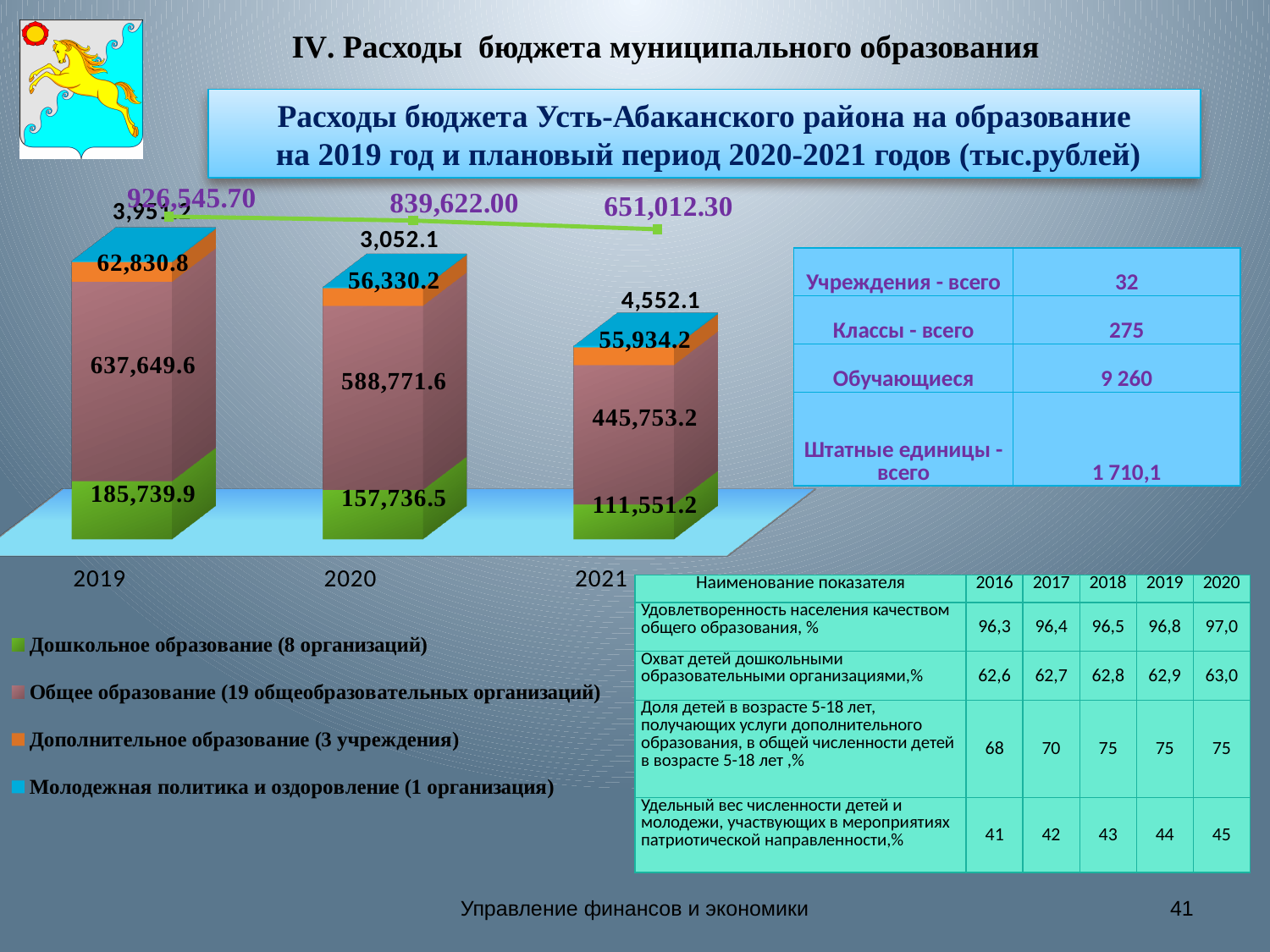
What is the value for Молодежная политика и оздоровление in 2021? 4,552.1 What is the value for Дополнительное образование in 2020? 56,330.2 In which year is the value for Дошкольное образование the lowest? 2021 What is the value for Общее образование in 2019? 637,649.6 How many years are shown on the x axis of the chart? 3 What value does the line above the bars show for 2019? 926,545.70 How many series does the chart legend list? 4 What is the difference between the Дошкольное образование values for 2019 and 2020? 28,003.4 What is the value for Дошкольное образование in 2021? 111,551.2 In which year is the value for Общее образование the highest? 2019 What is the difference between the line values for 2019 and 2020? 86,923.70 Do the line values rise or fall from 2019 to 2021? fall